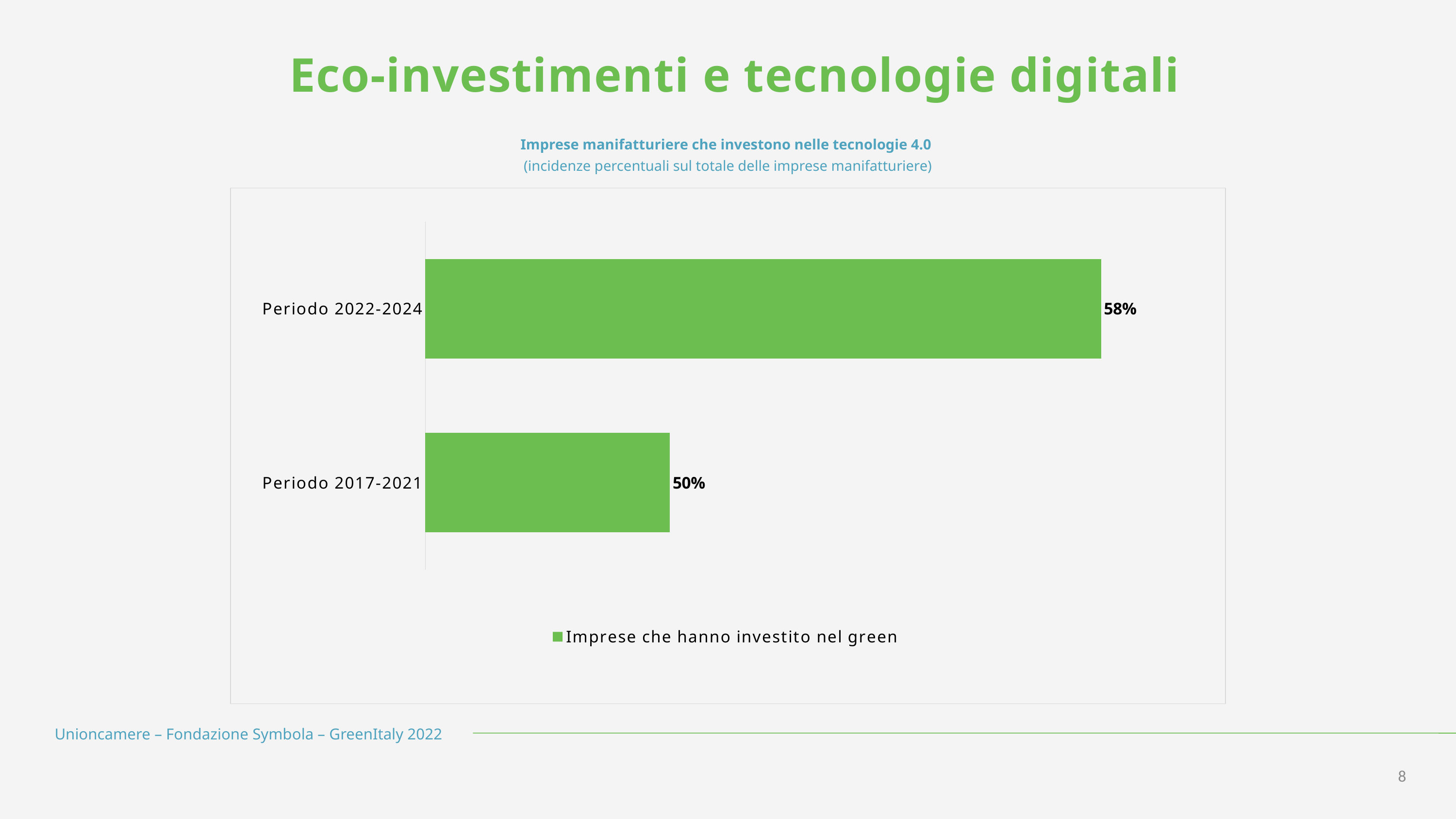
What is the legend entry of the chart? Imprese che hanno investito nel green How many series does the legend list? 1 What is the value for Periodo 2022-2024? 58% What is the value for Periodo 2017-2021? 50% Which period has the highest value? Periodo 2022-2024 What kind of chart is shown on the slide? Bar chart How many categories are shown in the chart? 2 What is the difference between the values for Periodo 2022-2024 and Periodo 2017-2021? 8% Which period has the lowest value? Periodo 2017-2021 What is the title of the chart? Imprese manifatturiere che investono nelle tecnologie 4.0 Which is larger, the value for Periodo 2022-2024 or the value for Periodo 2017-2021? Periodo 2022-2024